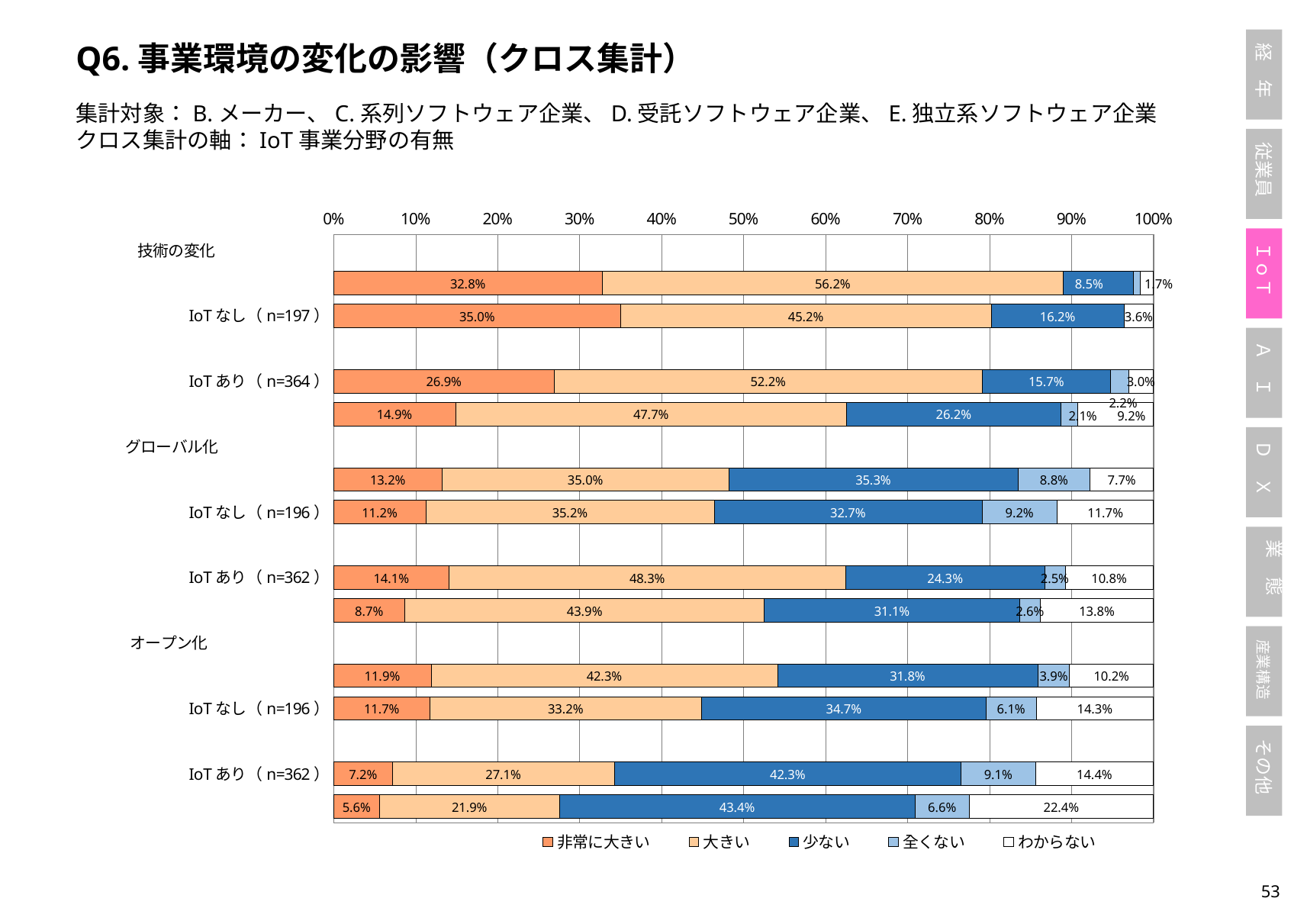
Which is larger, the 大きい value for グローバル化 IoT あり (n=362) or for グローバル化 IoT なし (n=196)? IoT あり (n=362) What is the 大きい value for the 技術の変化 IoT あり (n=364) bar? 52.2% What is the 少ない value for the グローバル化 IoT なし (n=196) bar? 32.7% What kind of chart is shown on the slide? stacked bar chart What is the difference between the 少ない values for オープン化 IoT あり (n=362) and オープン化 IoT なし (n=196)? 7.6% What is the first entry in the chart legend? 非常に大きい What is the 全くない value for the オープン化 IoT なし (n=196) bar? 6.1% How many series does the legend list? 5 What is the わからない value for the オープン化 IoT あり (n=362) bar? 14.4% What is the difference between the 非常に大きい values for 技術の変化 IoT なし (n=197) and 技術の変化 IoT あり (n=364)? 8.1% Which segment is the largest in the オープン化 IoT あり (n=362) bar? 少ない What is the 非常に大きい value for the 技術の変化 IoT なし (n=197) bar? 35.0%